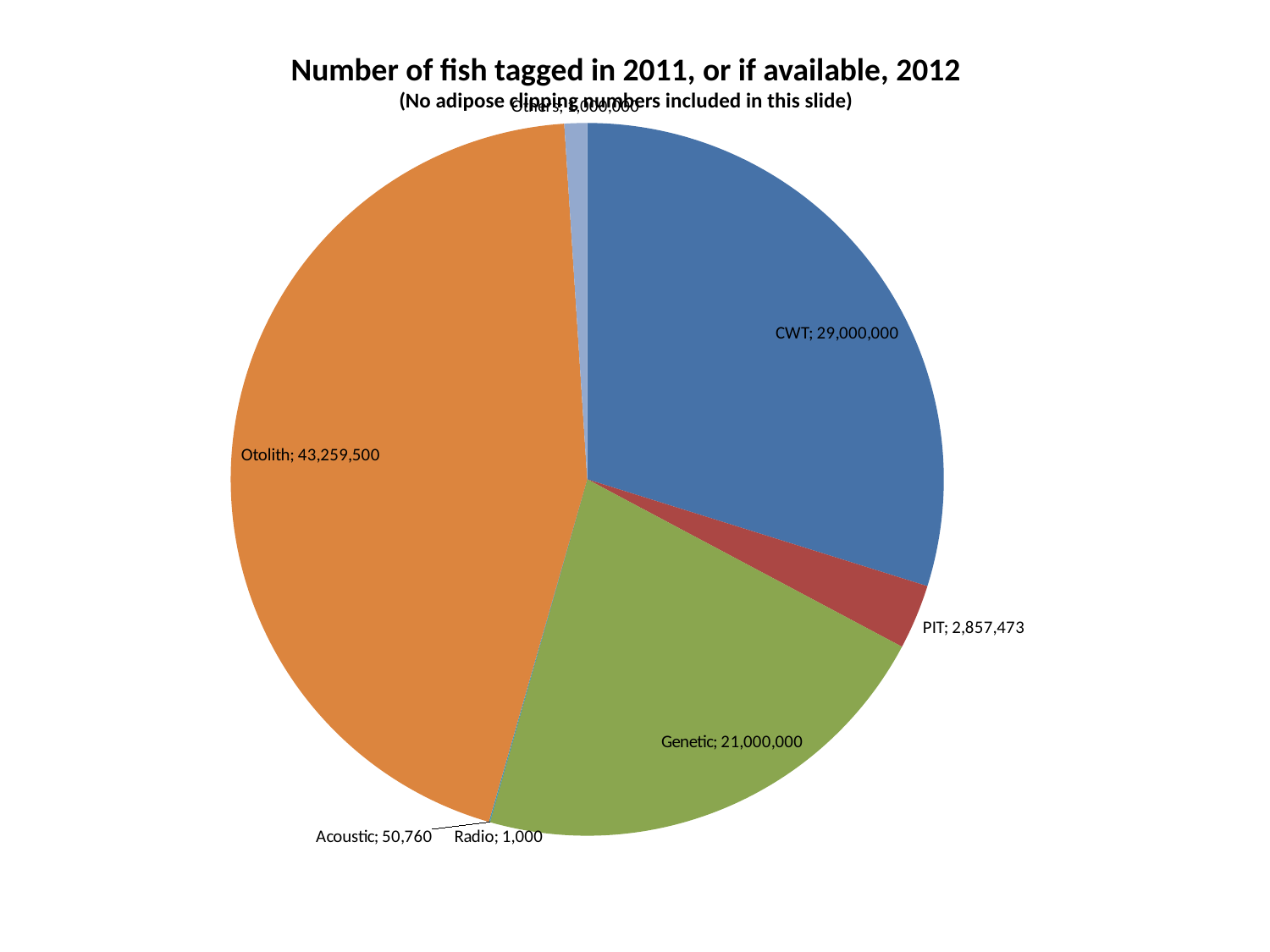
Which category has the smallest value shown? Radio What is the difference between the Otolith and CWT values? 14,259,500 What is the difference between the CWT and Genetic values? 8,000,000 What kind of chart is shown on the slide? Pie chart What is the main title of the chart? Number of fish tagged in 2011, or if available, 2012 Which category has the largest slice of the pie? Otolith What is the value for Genetic? 21,000,000 What is the value for PIT? 2,857,473 Which is larger, the value for CWT or the value for Genetic? CWT What is the value for CWT? 29,000,000 What is the value for Acoustic? 50,760 What is the value for Otolith? 43,259,500